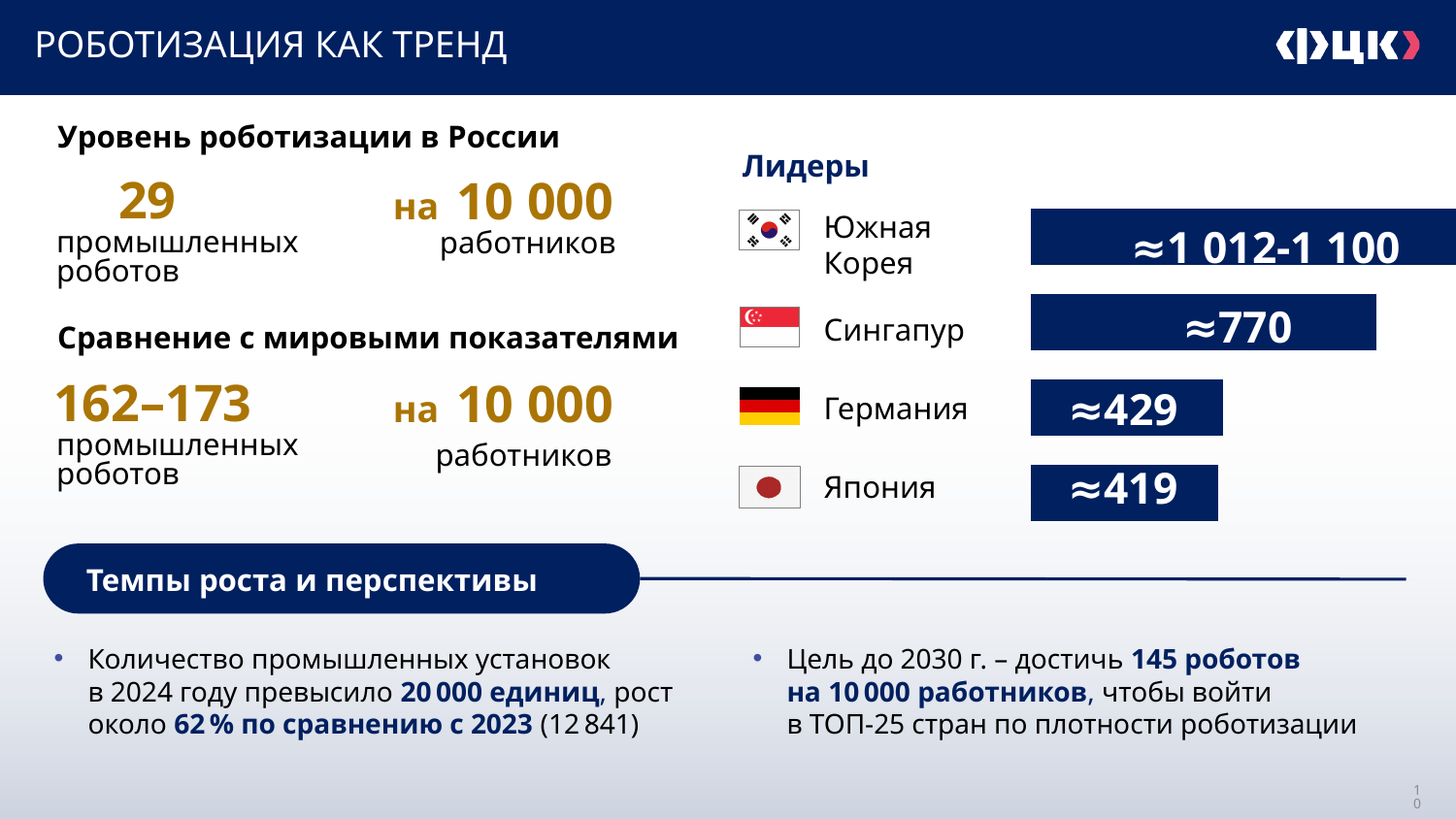
In the 'Лидеры' chart, which country is listed second from the top? Сингапур In the 'Лидеры' chart, which country has the lowest value? Япония What is the title of the chart listing Южная Корея, Сингапур, Германия and Япония? Лидеры In the 'Лидеры' chart, which country has the highest value? Южная Корея In the 'Лидеры' chart, which has the larger value, Южная Корея or Сингапур? Южная Корея In the 'Лидеры' chart, which has the larger value, Сингапур or Германия? Сингапур How many countries are shown in the 'Лидеры' chart? 4 What kind of chart is the 'Лидеры' chart? bar chart In the 'Лидеры' chart, what value is shown for Германия? ≈429 In the 'Лидеры' chart, what value is shown for Южная Корея? ≈1 012-1 100 In the 'Лидеры' chart, what value is shown for Япония? ≈419 In the 'Лидеры' chart, what value is shown for Сингапур? ≈770